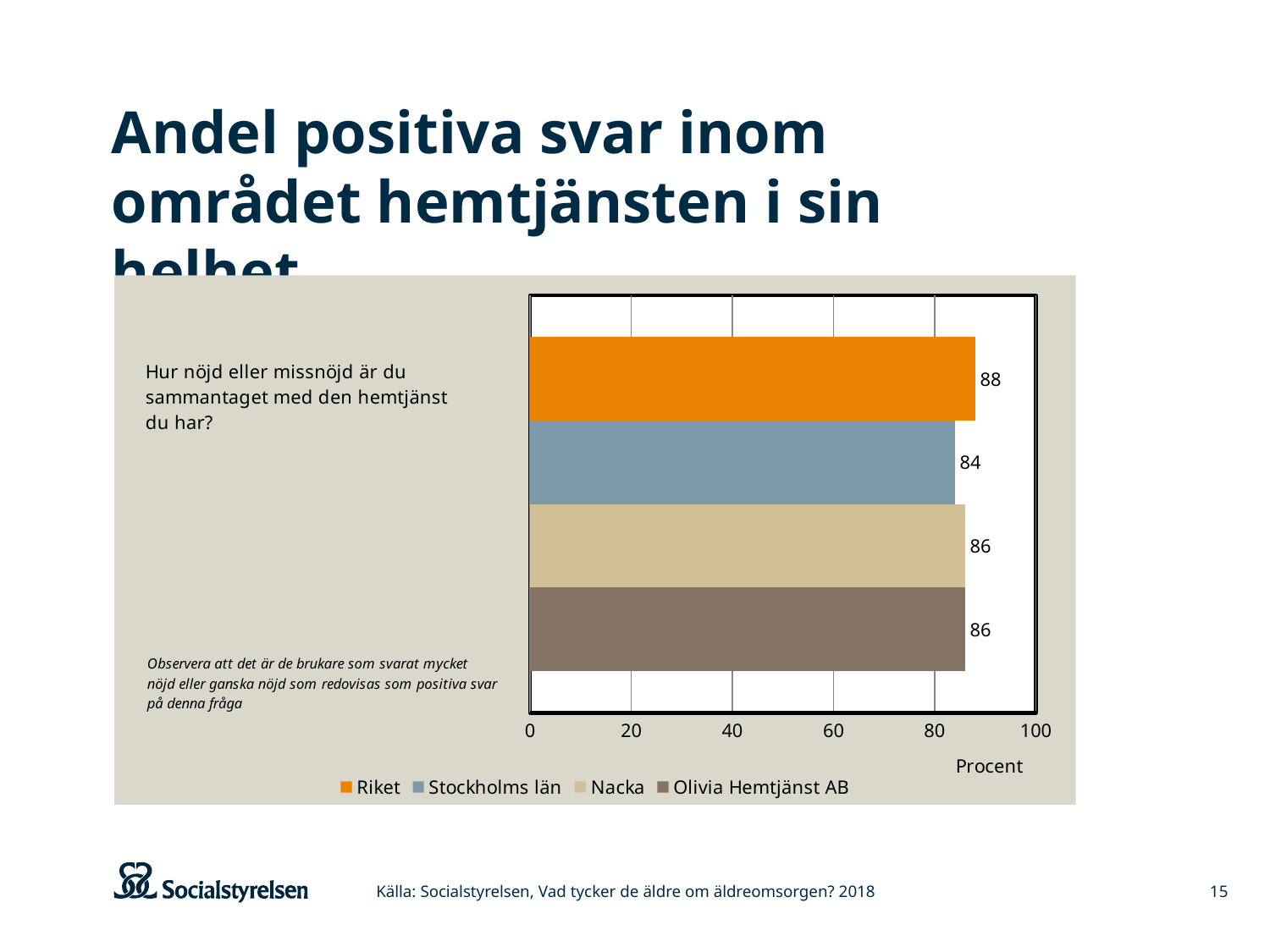
What is the value for Nacka? 86 What is the value for Olivia Hemtjänst AB? 86 What is the difference between the values for Riket and Stockholms län? 4 Is the value for Stockholms län greater or less than 80? greater What kind of chart is shown on the slide? Bar chart Which series has the highest value? Riket What is the value for Stockholms län? 84 What is the value for Riket? 88 How many series does the legend list? 4 Which series has the lowest value? Stockholms län What unit label is shown on the x axis? Procent Which is larger, the value for Riket or the value for Nacka? Riket